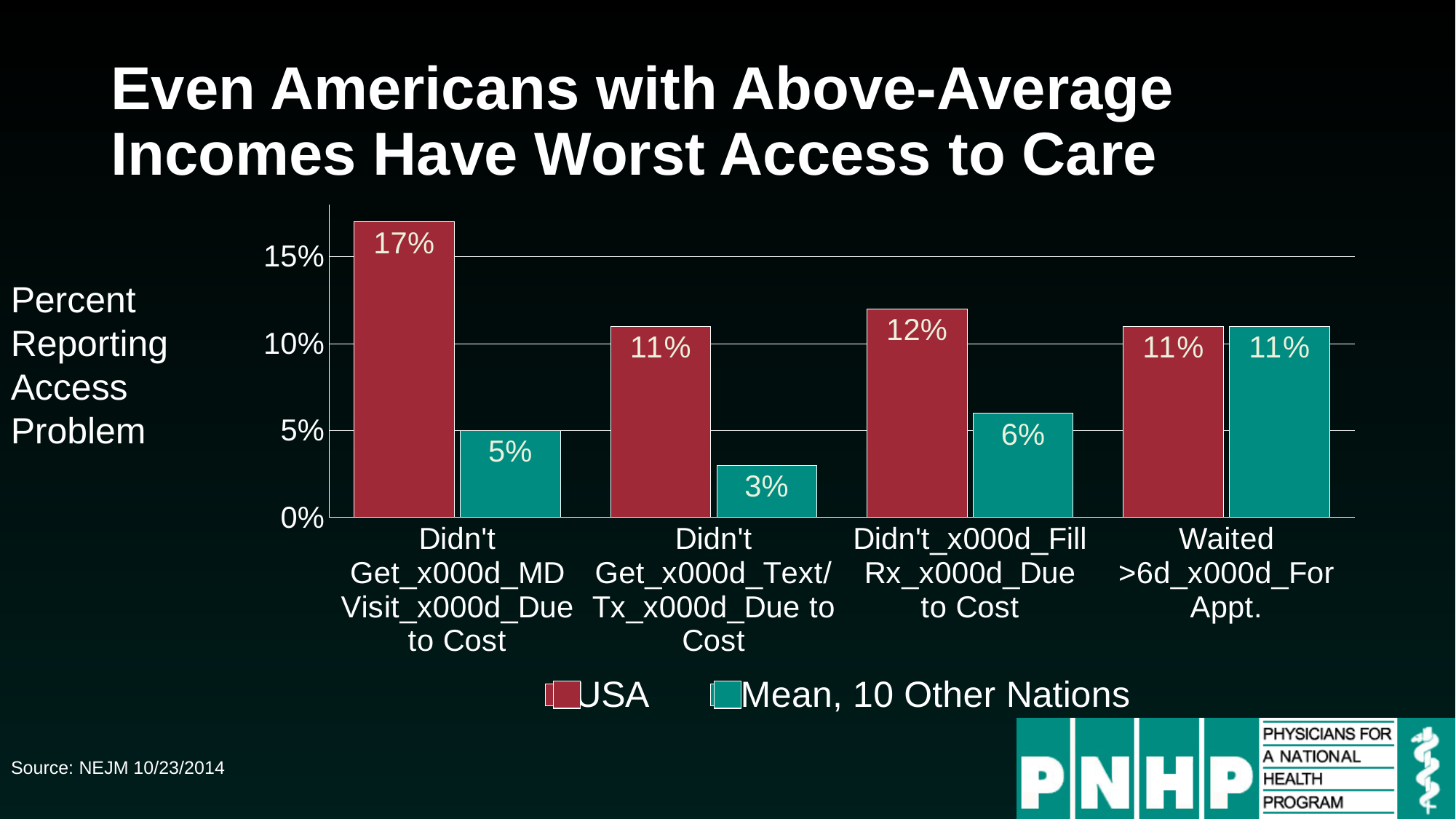
Which category has the highest USA value? Didn't Get MD Visit Due to Cost What is the value for Mean, 10 Other Nations for "Waited >6d For Appt."? 11% Which category has the lowest value for Mean, 10 Other Nations? Didn't Get Text/Tx Due to Cost How many categories are shown on the x axis? 4 For "Didn't Fill Rx Due to Cost", which is larger: the USA value or the Mean, 10 Other Nations value? USA What is the source cited at the bottom of the slide? NEJM 10/23/2014 What is the USA value for "Didn't Fill Rx Due to Cost"? 12% How many series does the legend list? 2 What is the difference between the USA value and the Mean, 10 Other Nations value for "Didn't Get MD Visit Due to Cost"? 12% What is the value for Mean, 10 Other Nations for "Didn't Get Text/Tx Due to Cost"? 3% What kind of chart is shown on the slide? Bar chart What is the USA value for "Didn't Get MD Visit Due to Cost"? 17%